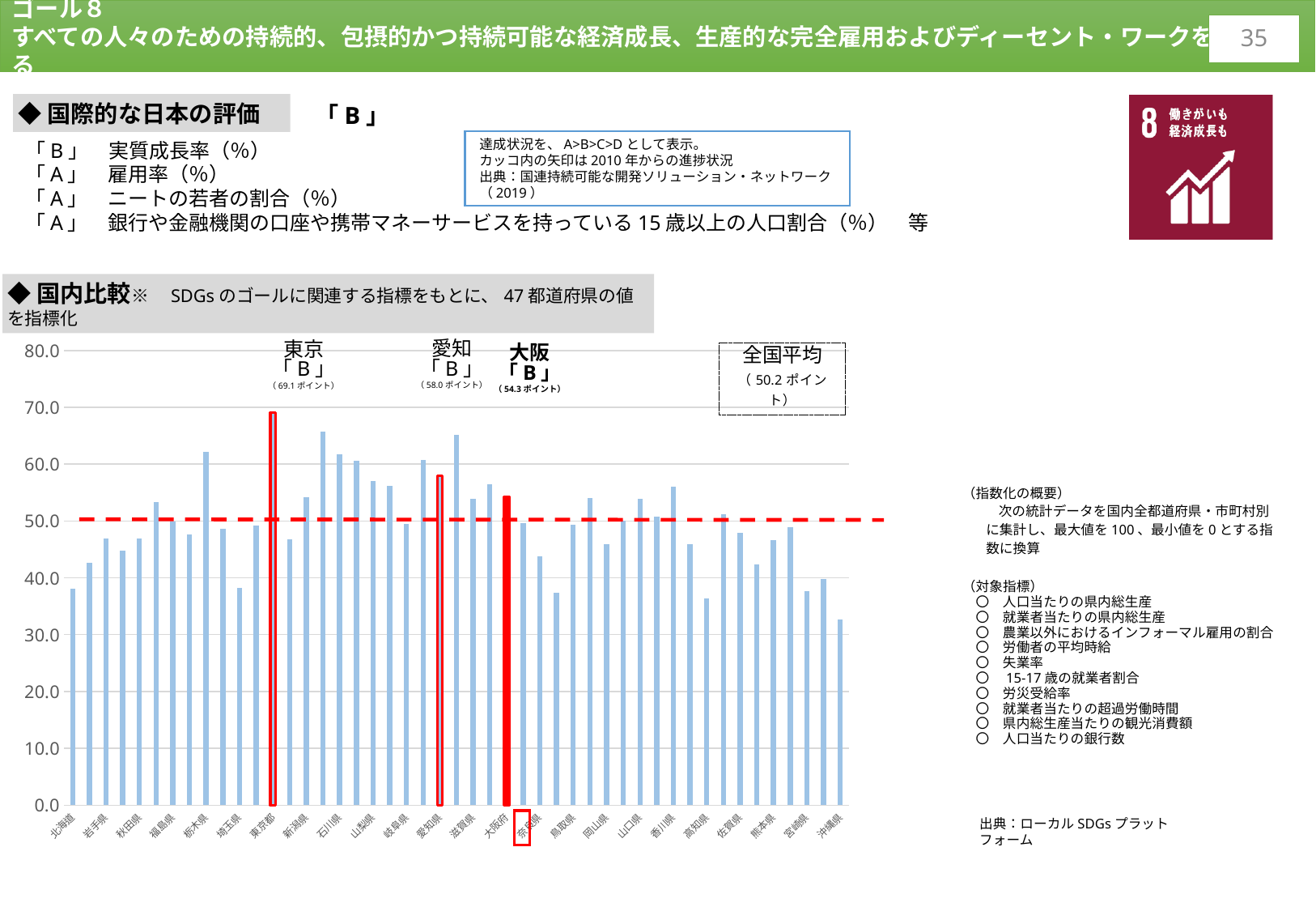
In the 国内比較 bar chart, what value is printed for 愛知? 58.0 ポイント In the 国内比較 bar chart, what is the difference between the printed values for 東京 and 愛知? 11.1 ポイント In the 国内比較 bar chart, which has the larger value, 東京 or 大阪? 東京 In the 国内比較 bar chart, is the value for 沖縄県 greater or less than 40.0? less In the 国内比較 bar chart, what is the difference between the printed values for 東京 and 大阪? 14.8 ポイント In the 国内比較 bar chart, what value is printed for 大阪? 54.3 ポイント What kind of chart is used for the 国内比較 section? bar chart In the 国内比較 bar chart, which prefecture has the highest bar? 東京都 In the 国内比較 bar chart, what is the 全国平均 value shown? 50.2 ポイント In the 国内比較 bar chart, what value is printed for 東京? 69.1 ポイント In the 国内比較 bar chart, which prefecture has the lowest bar? 沖縄県 In the 国内比較 bar chart, what does the red dashed horizontal line represent? 全国平均 (50.2 ポイント)